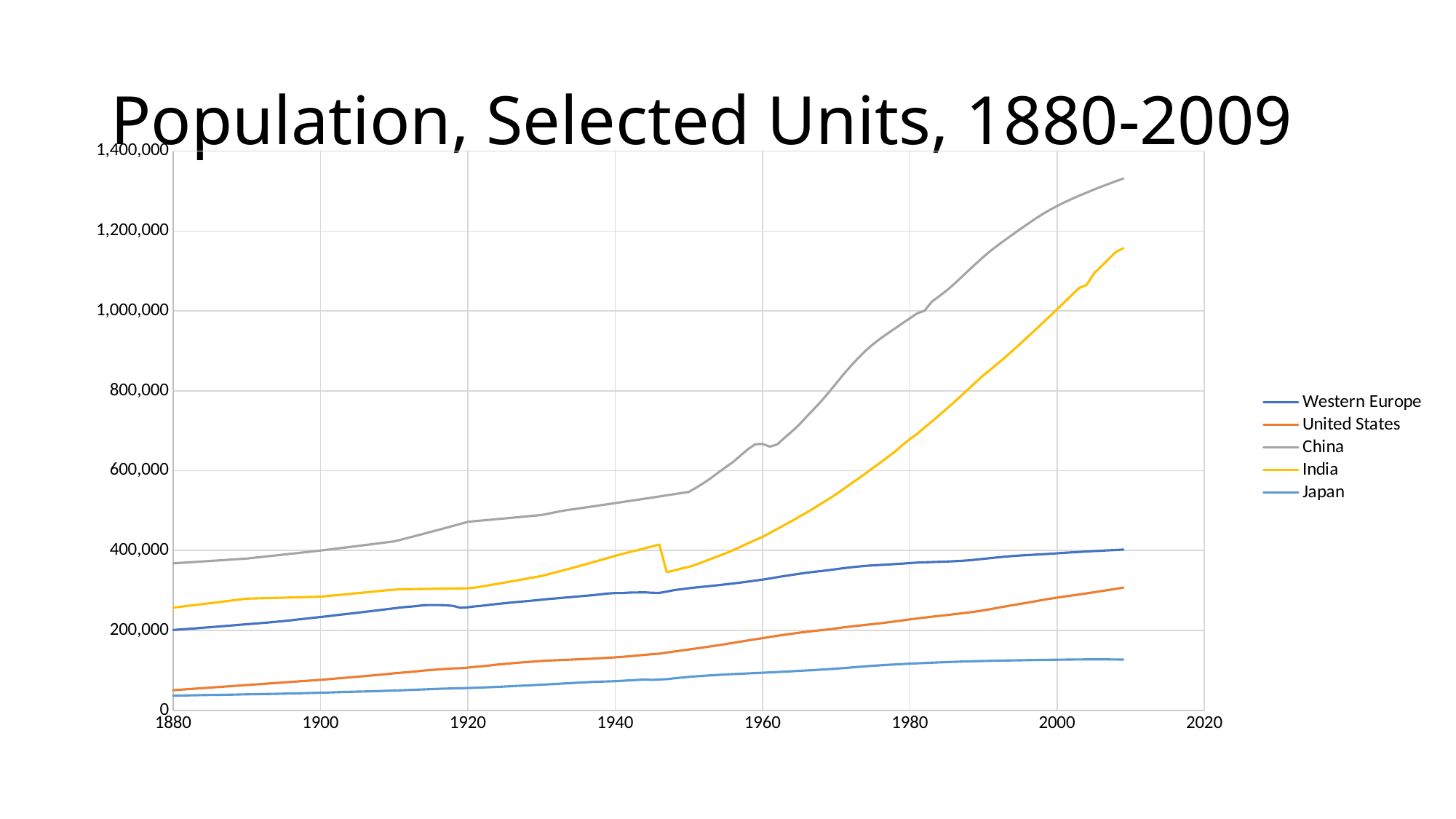
Is the value for India in 1980 greater or less than 600,000? greater Which series has the lowest population across the whole period? Japan Is the value for China in 1880 greater or less than 400,000? less How many series does the legend list? 5 In 1880, which is larger: Western Europe or United States? Western Europe Is the value for China in 2000 greater or less than 1,200,000? greater Which series has the highest population in 2009? China Does the population of China rise or fall from 1880 to 2009? Rises What is the title of the chart? Population, Selected Units, 1880-2009 What kind of chart is shown on the slide? Line chart Which colour is used for the India series? Yellow